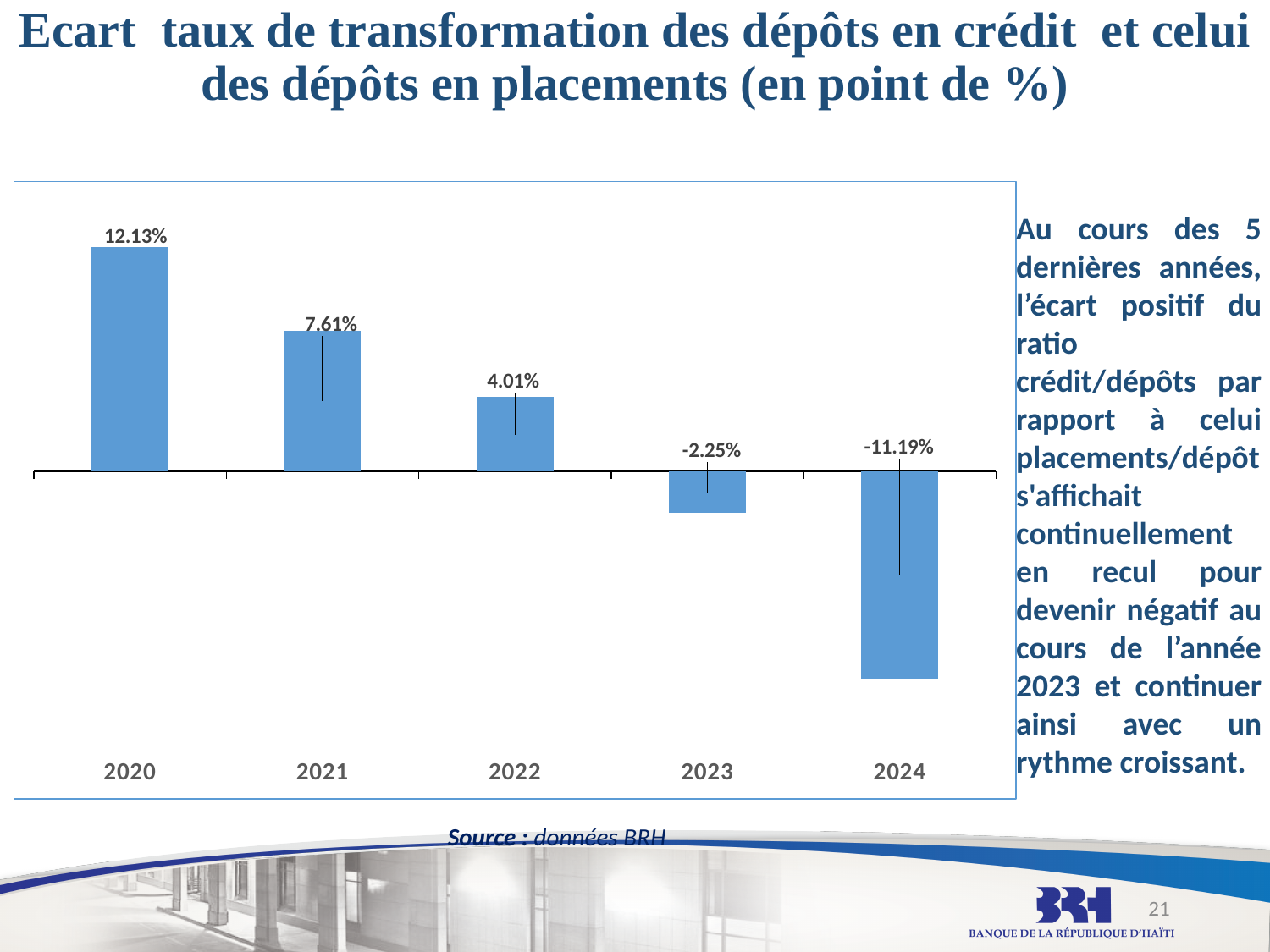
Which is larger, the value for 2021 or the value for 2022? 2021 What is the value for 2024? -11.19% Do the values rise or fall from 2020 to 2024? Fall What is the value for 2020? 12.13% What is the value for 2023? -2.25% What is the source cited below the chart? Source : données BRH Which year has the lowest value? 2024 How many years are shown on the x axis? 5 Which year has the highest value? 2020 What is the difference between the values for 2020 and 2021? 4.52 percentage points What is the value for 2022? 4.01% What kind of chart is shown? Bar chart